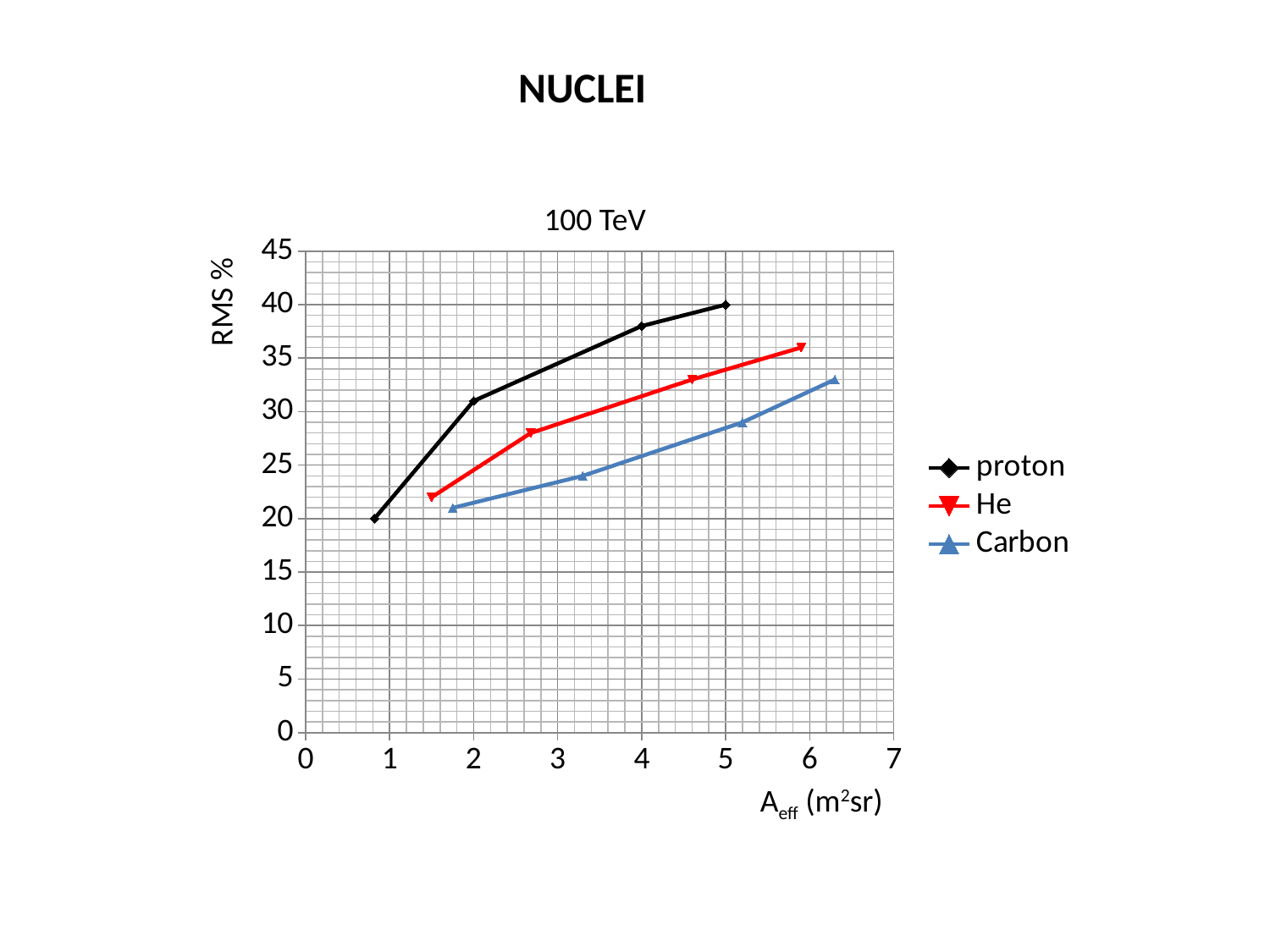
Which series reaches the highest RMS % value on the chart? proton How many data points are plotted for the proton series? 4 Is the lowest RMS % value of the Carbon series greater or less than 25? less At A_eff = 4 m²sr, which series has the highest RMS %? proton Does the RMS % for the proton series rise or fall as A_eff increases? rise Is the highest RMS % value of the proton series greater or less than 35? greater How many series does the legend list? 3 What colour is the He series drawn in? red What kind of chart is shown on the slide? line chart Is the last (rightmost) RMS % value of the He series greater or less than 30? greater What is the title of the chart? 100 TeV Does the RMS % for the Carbon series rise or fall as A_eff increases? rise